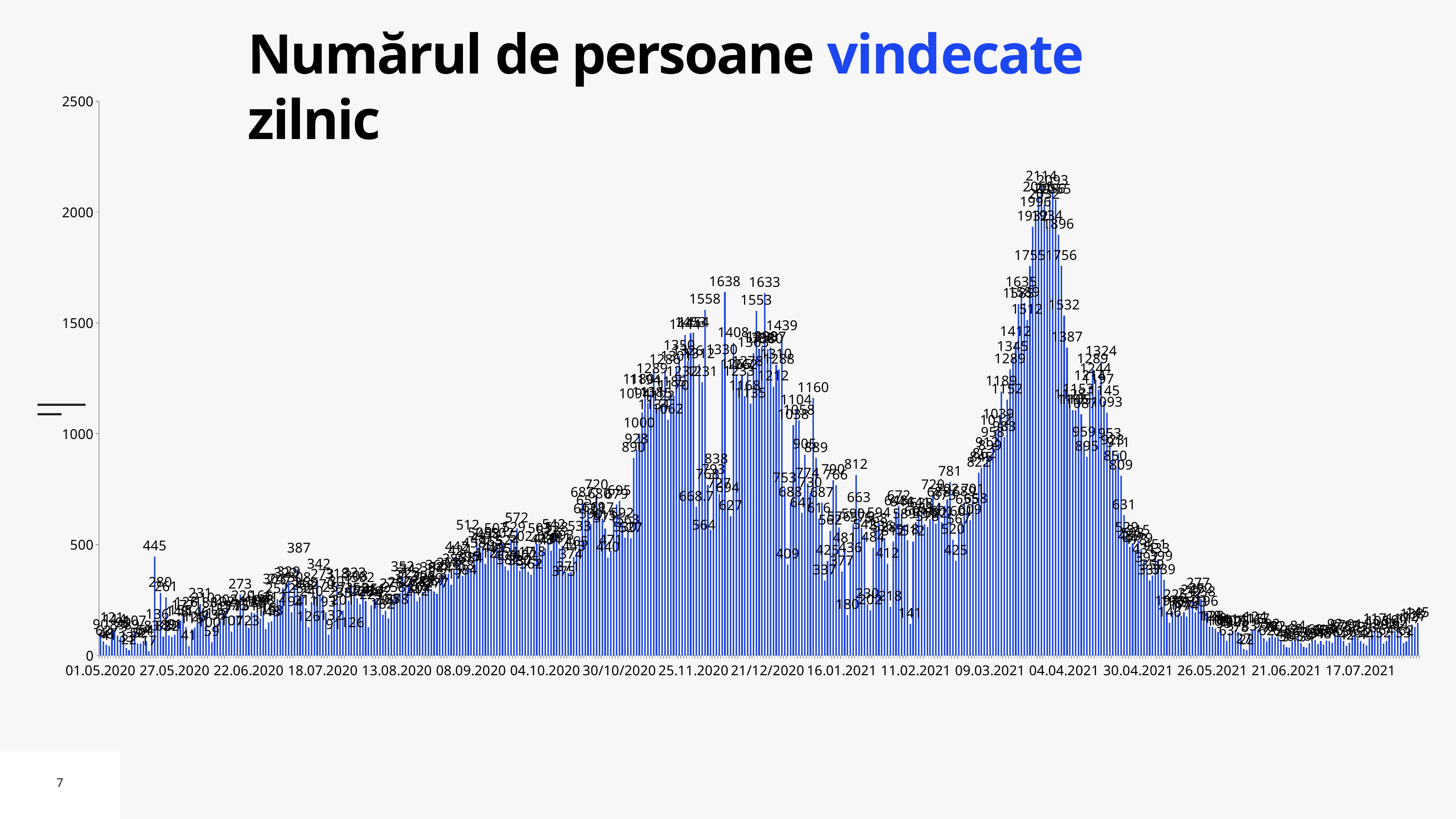
Is the highest bar on the chart greater or less than 2000? greater What is the first date label on the horizontal axis? 01.05.2020 What kind of chart is shown on the slide? bar chart Which is larger, the peak labelled 2114 around April 2021 or the peak labelled 1638 around December 2020? 2114 Are the bars around 17.07.2021 greater or less than 500? less Do the values rise or fall between 04.04.2021 and 30.04.2021? fall What is the title of the chart on the slide? Numărul de persoane vindecate zilnic What is the difference between the labelled values 445 and 387 in the first part of the chart? 58 What is the highest value labelled on the chart? 2114 What is the highest value shown on the vertical axis? 2500 Do the values rise or fall between 09.03.2021 and 04.04.2021? rise What is the difference between the peak value 2114 and the earlier peak value 1638? 476